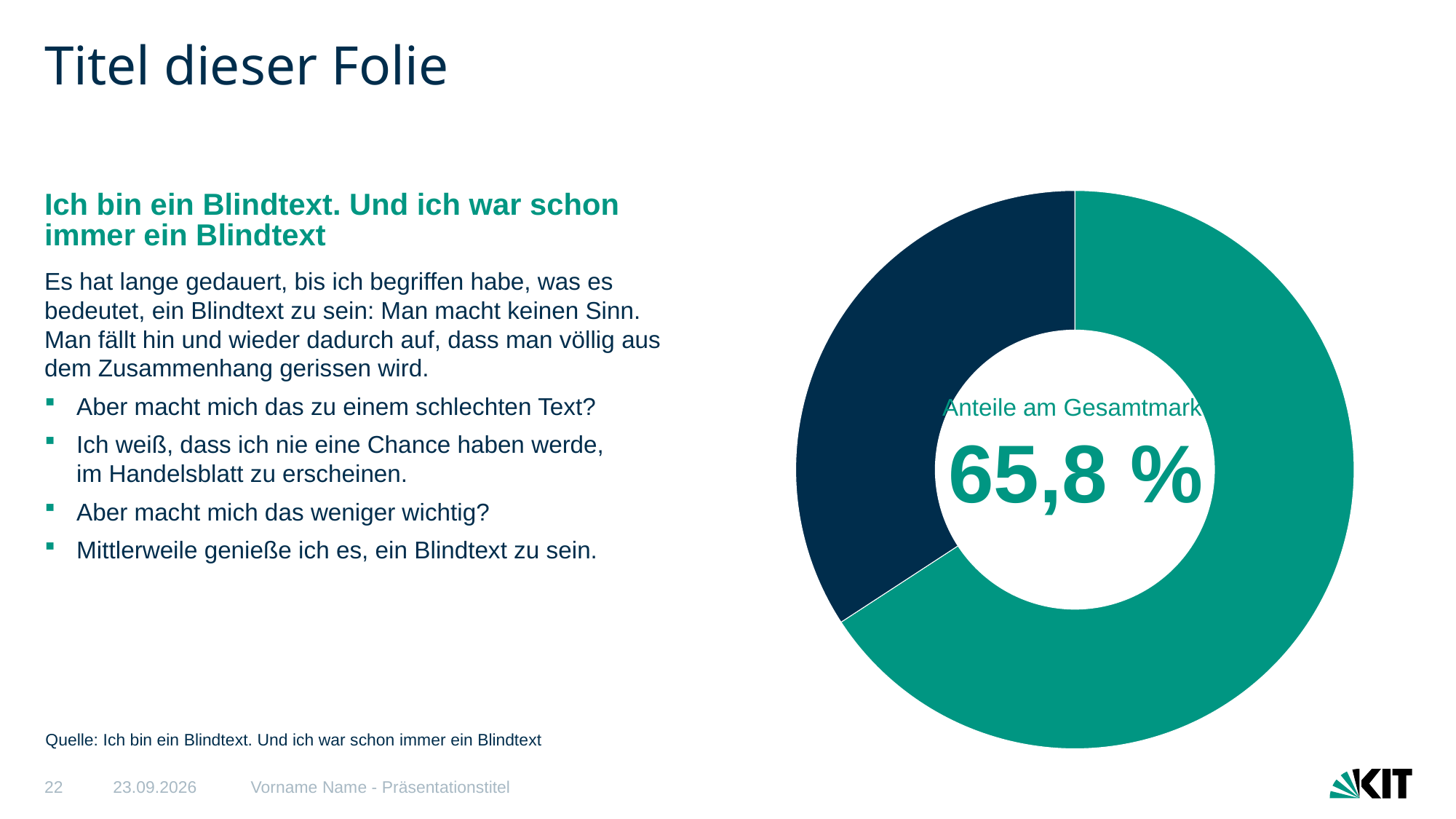
What share of the donut chart does the green slice represent? 65,8 % Is the green slice of the donut chart greater or less than half of the chart? greater Does the donut chart have a legend? No What colour is the larger slice of the donut chart? Green Which slice of the donut chart is the smallest? The dark navy slice Which slice of the donut chart is larger, the green one or the dark navy one? The green one What kind of chart is shown on the slide? Donut (pie) chart What percentage is printed in the centre of the donut chart? 65,8 % How many slices does the donut chart have? 2